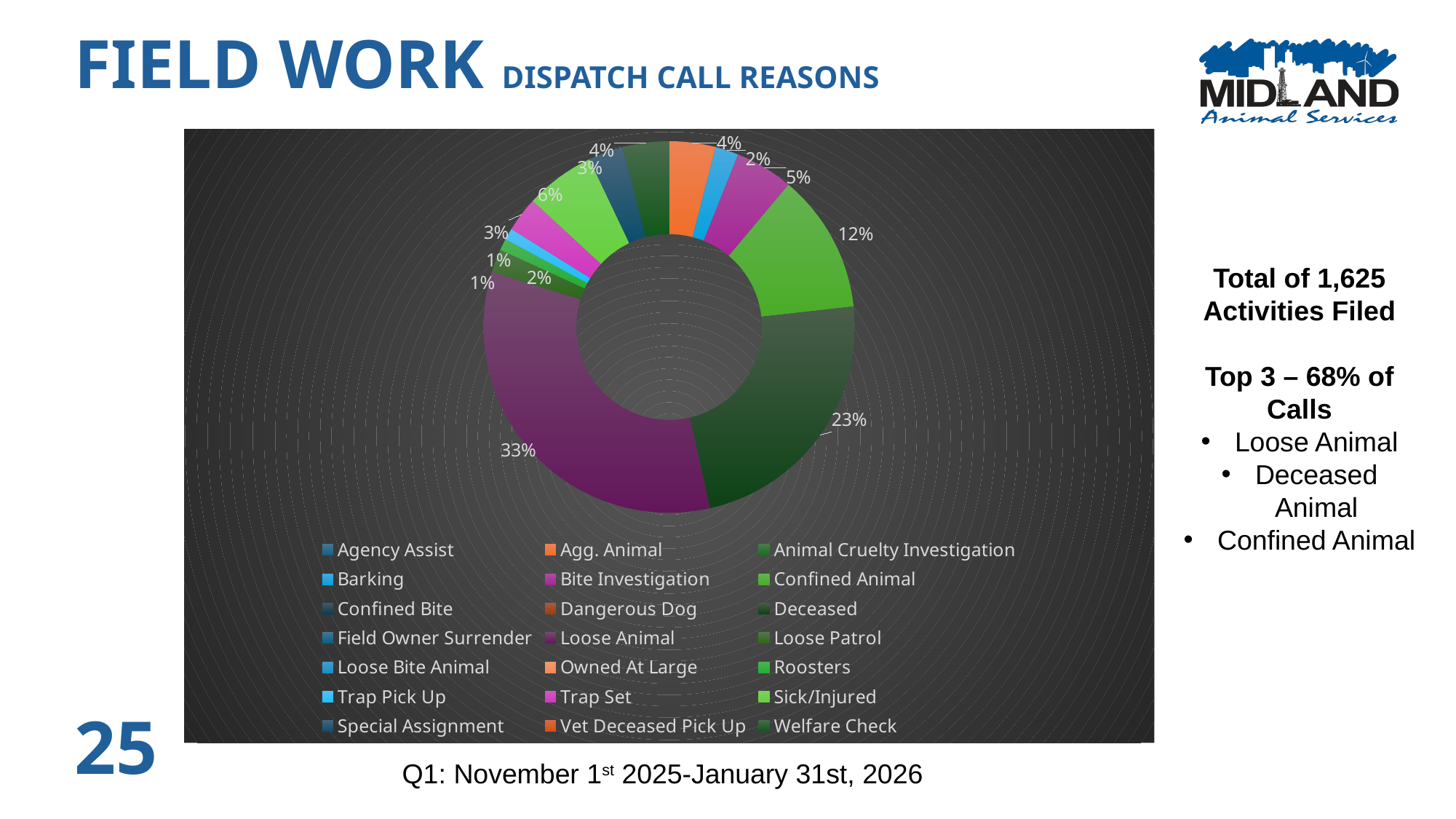
What percentage of dispatch calls is shown for Loose Animal? 33% How many dispatch call reasons are listed in the chart legend? 21 Which has a larger share, Confined Animal or Bite Investigation? Confined Animal Which dispatch call reason has the largest share of the chart? Loose Animal What percentage of dispatch calls is shown for Confined Animal? 12% What percentage of dispatch calls is shown for Agg. Animal? 4% What percentage of dispatch calls is shown for Bite Investigation? 5% What is the total number of activities filed stated on the slide? 1,625 What combined share of calls do the top 3 reasons account for, according to the slide? 68% What kind of chart is shown on the slide? Pie (donut) chart How many percentage points larger is the Loose Animal share than the Deceased share? 10 What percentage of dispatch calls is shown for Deceased? 23%